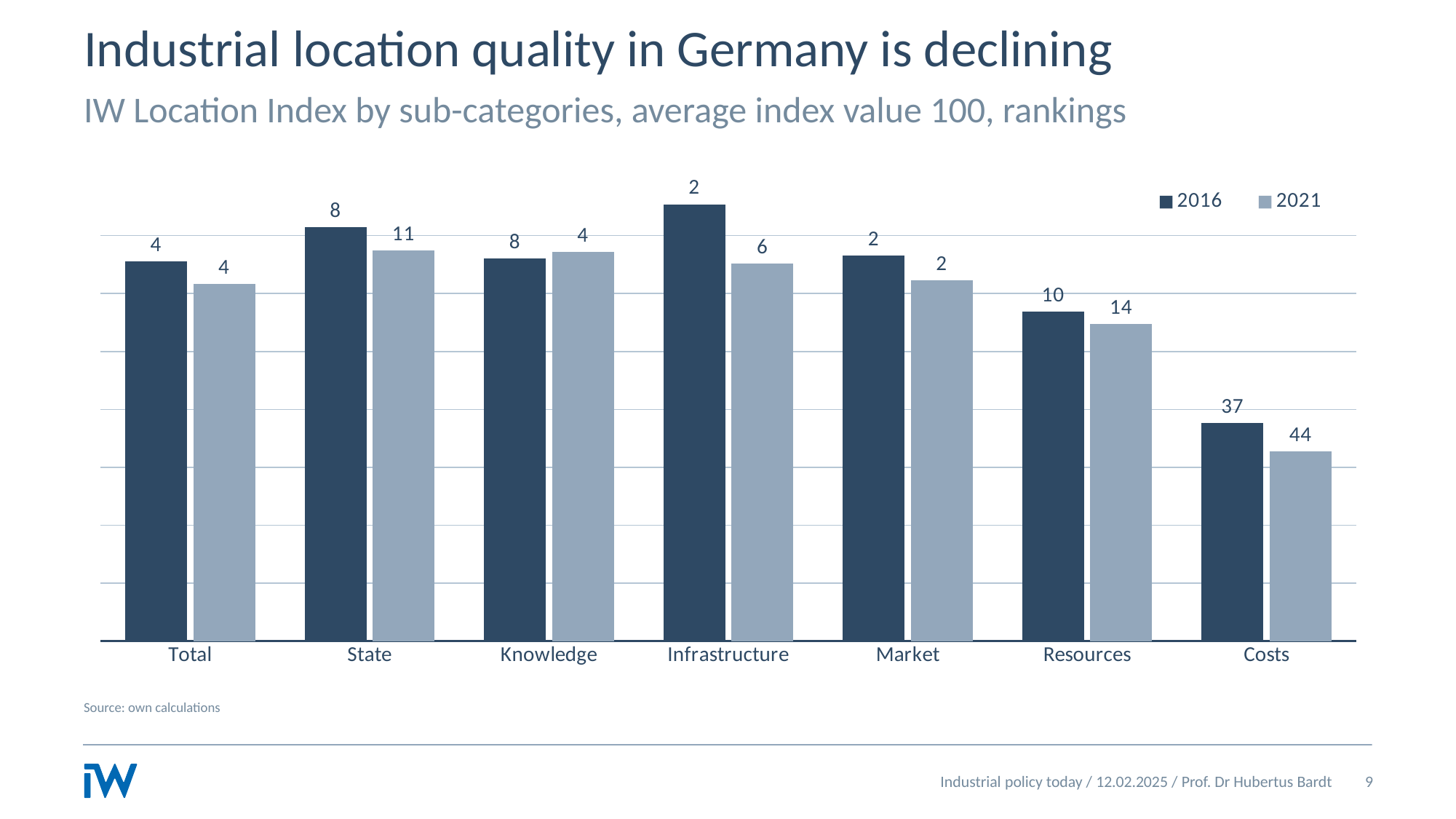
What is the difference between the 2021 and 2016 values for Resources? 4 What is the difference between the 2021 and 2016 values for Costs? 7 How many series does the legend list? 2 Which category has the largest labelled value for 2021? Costs How many categories are shown on the x axis? 7 What is the 2021 value for Resources? 14 Which is larger, the 2016 value for Costs or the 2021 value for Costs? 2021 (44) What is the 2016 value for Costs? 37 What is the 2021 value for Knowledge? 4 What kind of chart is shown on the slide? Bar chart What is the 2021 value for State? 11 What is the 2016 value for Infrastructure? 2